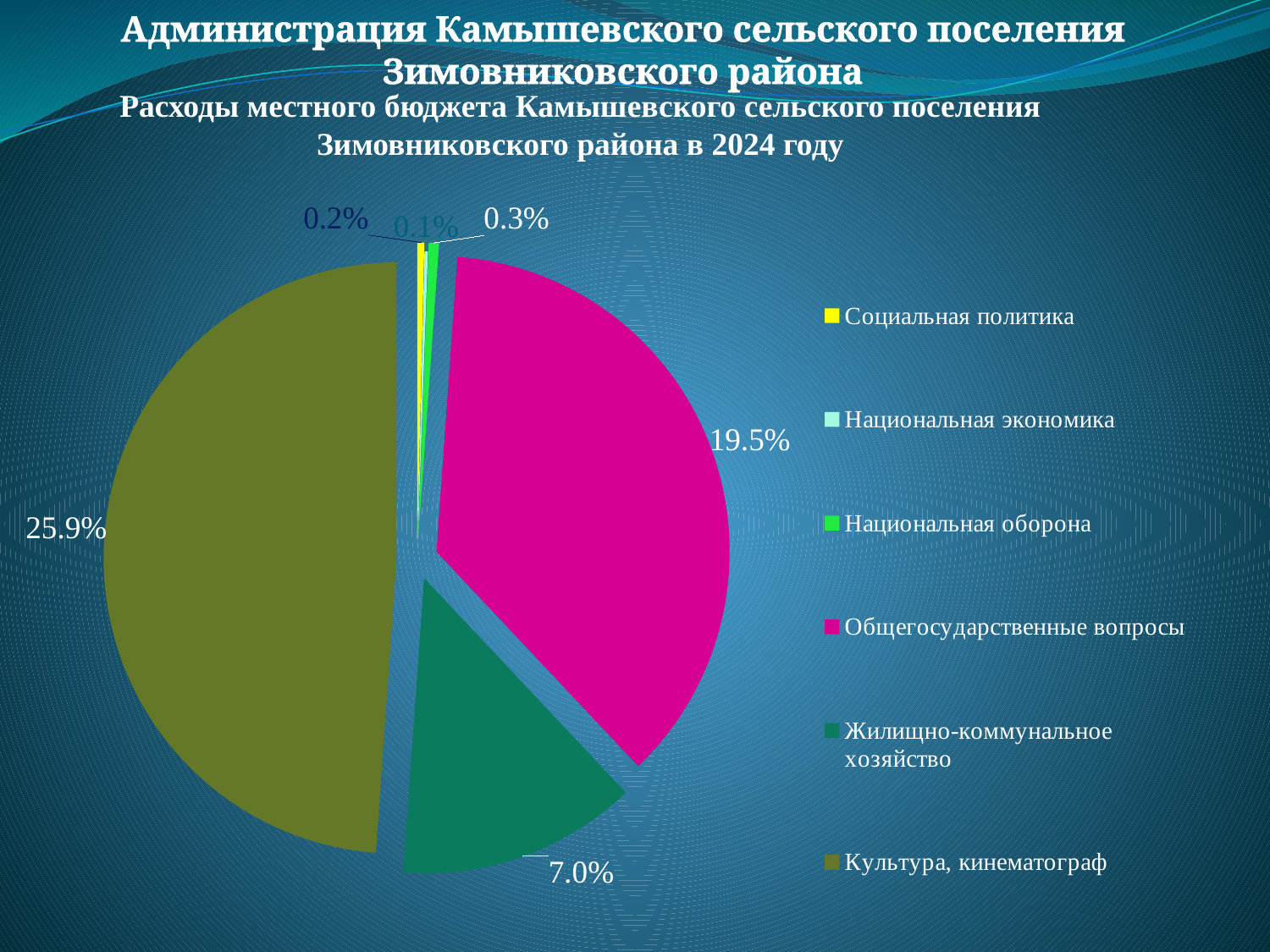
How many categories does the legend list? 6 Which category has the largest share of the pie? Культура, кинематограф Which year do the budget expenditures in the chart refer to? 2024 Which category has the smallest share of the pie? Национальная экономика What kind of chart is shown on the slide? pie chart What percentage is shown for Национальная оборона? 0.3% What percentage is shown for Культура, кинематограф? 25.9% What percentage is shown for Жилищно-коммунальное хозяйство? 7.0% Which is larger: the share for Общегосударственные вопросы or for Жилищно-коммунальное хозяйство? Общегосударственные вопросы What percentage is shown for Социальная политика? 0.2% What percentage is shown for Общегосударственные вопросы? 19.5% What is the difference between the percentages for Культура, кинематограф and Общегосударственные вопросы? 6.4%